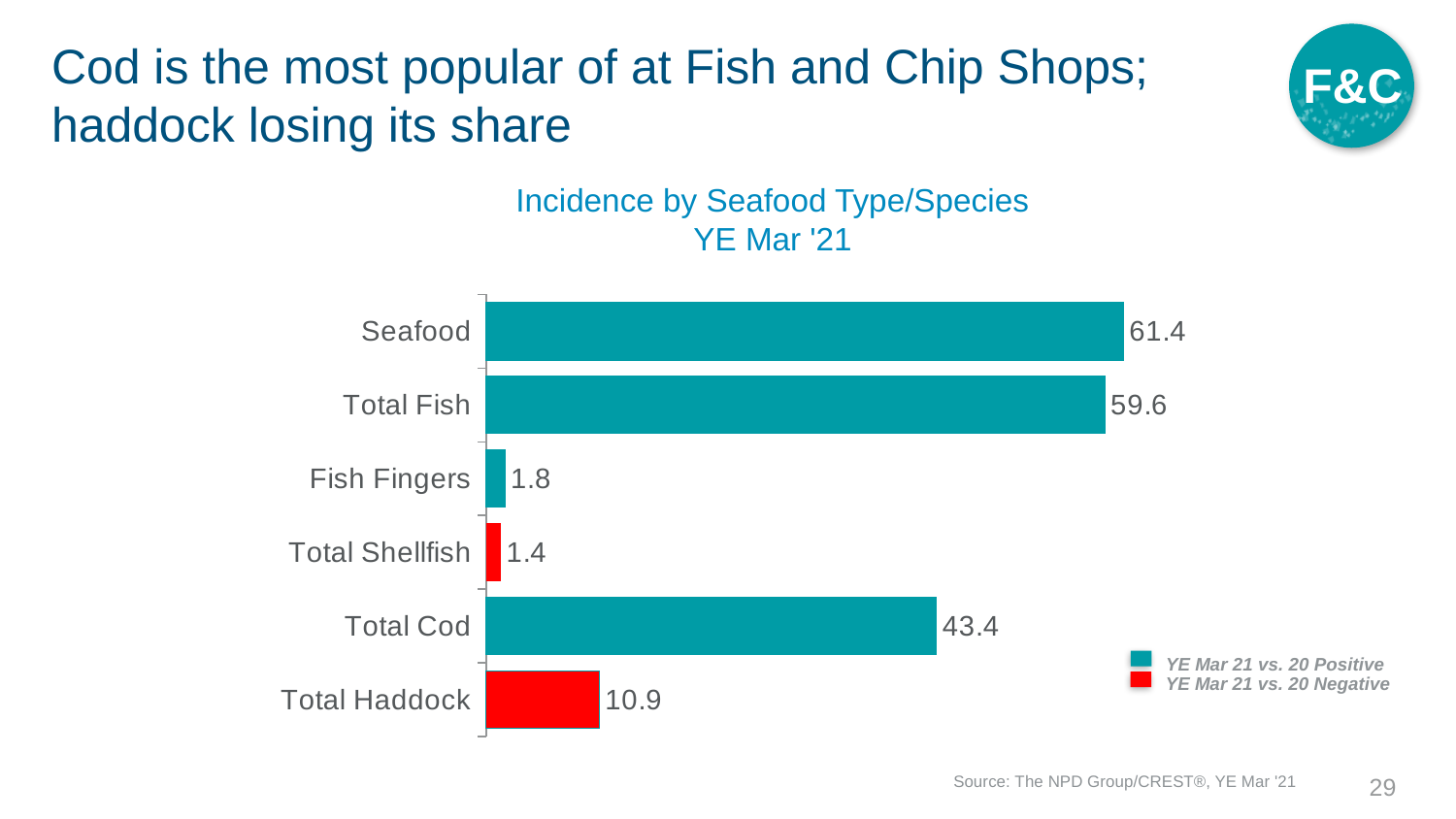
Which categories are shown in red, indicating a negative change YE Mar 21 vs. 20? Total Shellfish and Total Haddock What is the difference between the values for Seafood and Total Fish? 1.8 What kind of chart is shown on the slide? Bar chart What is the title of the chart? Incidence by Seafood Type/Species YE Mar '21 What is the value for Seafood? 61.4 Which category has the lowest value? Total Shellfish What is the value for Total Haddock? 10.9 Which category has the highest value? Seafood How many categories are shown in the chart? 6 What is the difference between the values for Total Cod and Total Haddock? 32.5 What is the value for Total Shellfish? 1.4 Which is larger, the value for Fish Fingers or the value for Total Shellfish? Fish Fingers